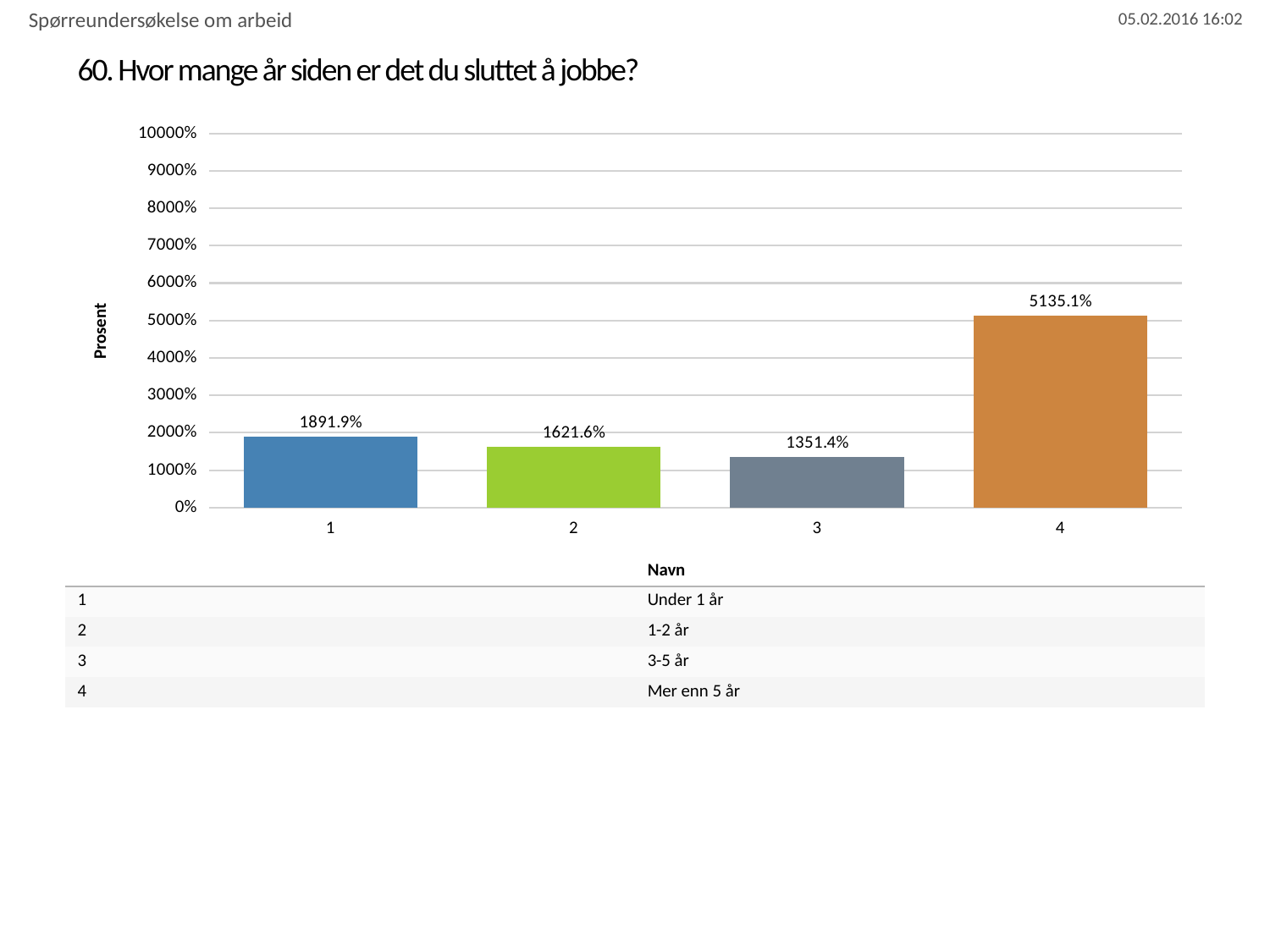
What is the difference between the values for category 1 and category 2? 270.3% Which category has the lowest value? 3 (3-5 år) Which is larger, the value for category 2 or category 3? Category 2 What kind of chart is shown on the slide? Bar chart How many categories are shown on the x axis? 4 What is the value for category 3 (3-5 år)? 1351.4% What is the value for category 4 (Mer enn 5 år)? 5135.1% What is the value for category 2 (1-2 år)? 1621.6% What is the difference between the values for category 4 and category 1? 3243.2% Is the value for category 4 greater or less than 5000%? greater What is the value for category 1 (Under 1 år)? 1891.9% Which category has the highest value? 4 (Mer enn 5 år)